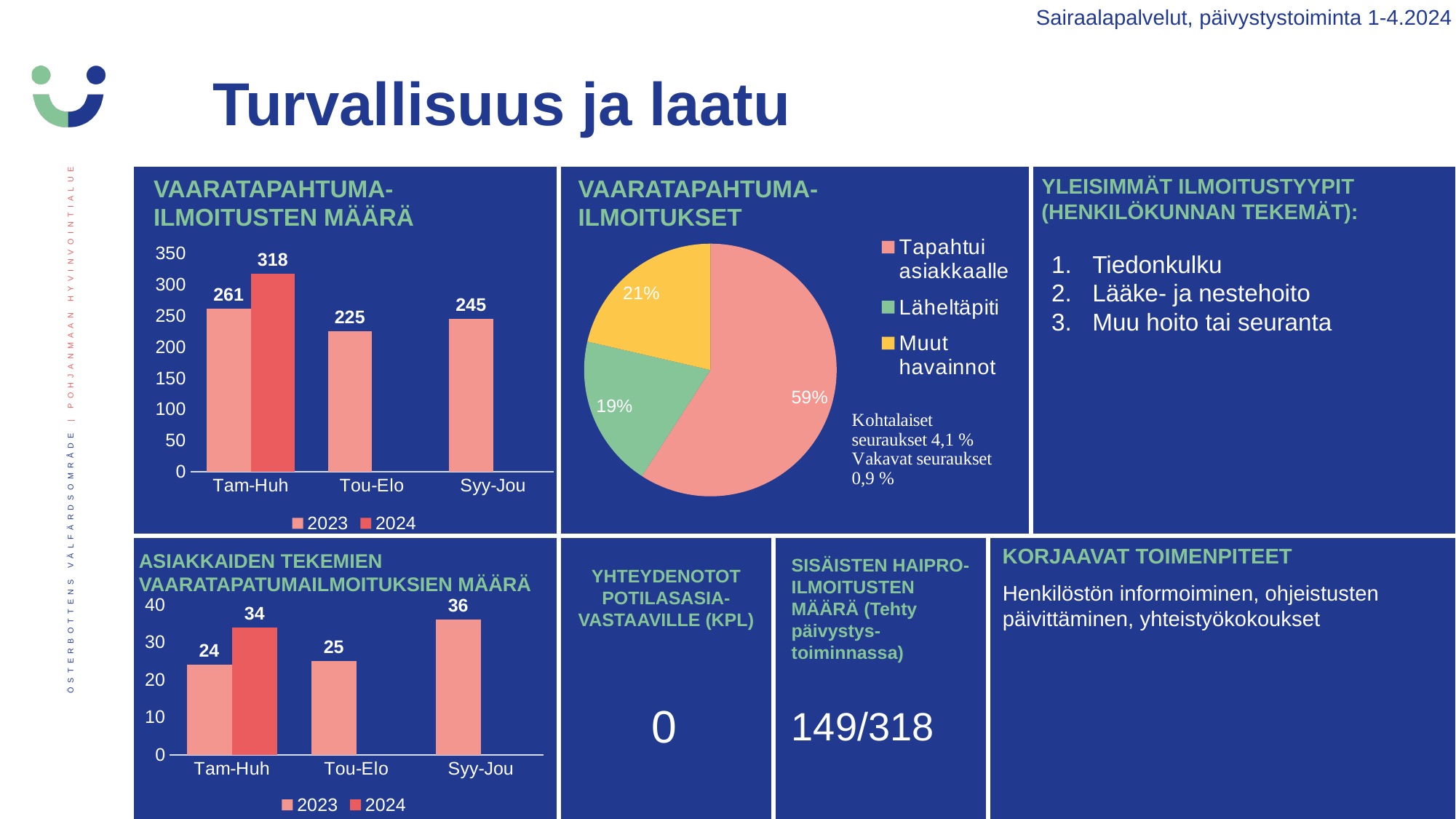
In the chart titled VAARATAPAHTUMA-ILMOITUSTEN MÄÄRÄ, what is the 2024 value for Tam-Huh? 318 In the chart titled VAARATAPAHTUMA-ILMOITUSTEN MÄÄRÄ, what is the 2023 value for Tou-Elo? 225 In the chart titled VAARATAPAHTUMA-ILMOITUSTEN MÄÄRÄ, how many series does the legend list? 2 In the pie chart titled VAARATAPAHTUMA-ILMOITUKSET, what share is Tapahtui asiakkaalle? 59% In the chart titled VAARATAPAHTUMA-ILMOITUSTEN MÄÄRÄ, what is the difference between the 2024 and 2023 values for Tam-Huh? 57 In the pie chart titled VAARATAPAHTUMA-ILMOITUKSET, what share is Läheltäpiti? 19% In the chart titled ASIAKKAIDEN TEKEMIEN VAARATAPATUMAILMOITUKSIEN MÄÄRÄ, how many periods are shown on the x axis? 3 What kind of chart is the one titled VAARATAPAHTUMA-ILMOITUKSET? Pie chart In the pie chart titled VAARATAPAHTUMA-ILMOITUKSET, which slice is the largest? Tapahtui asiakkaalle In the chart titled ASIAKKAIDEN TEKEMIEN VAARATAPATUMAILMOITUKSIEN MÄÄRÄ, what is the 2023 value for Syy-Jou? 36 In the chart titled VAARATAPAHTUMA-ILMOITUSTEN MÄÄRÄ, which period has the lowest 2023 value? Tou-Elo In the chart titled ASIAKKAIDEN TEKEMIEN VAARATAPATUMAILMOITUKSIEN MÄÄRÄ, which is larger: the 2024 value for Tam-Huh or the 2023 value for Tou-Elo? 2024 value for Tam-Huh